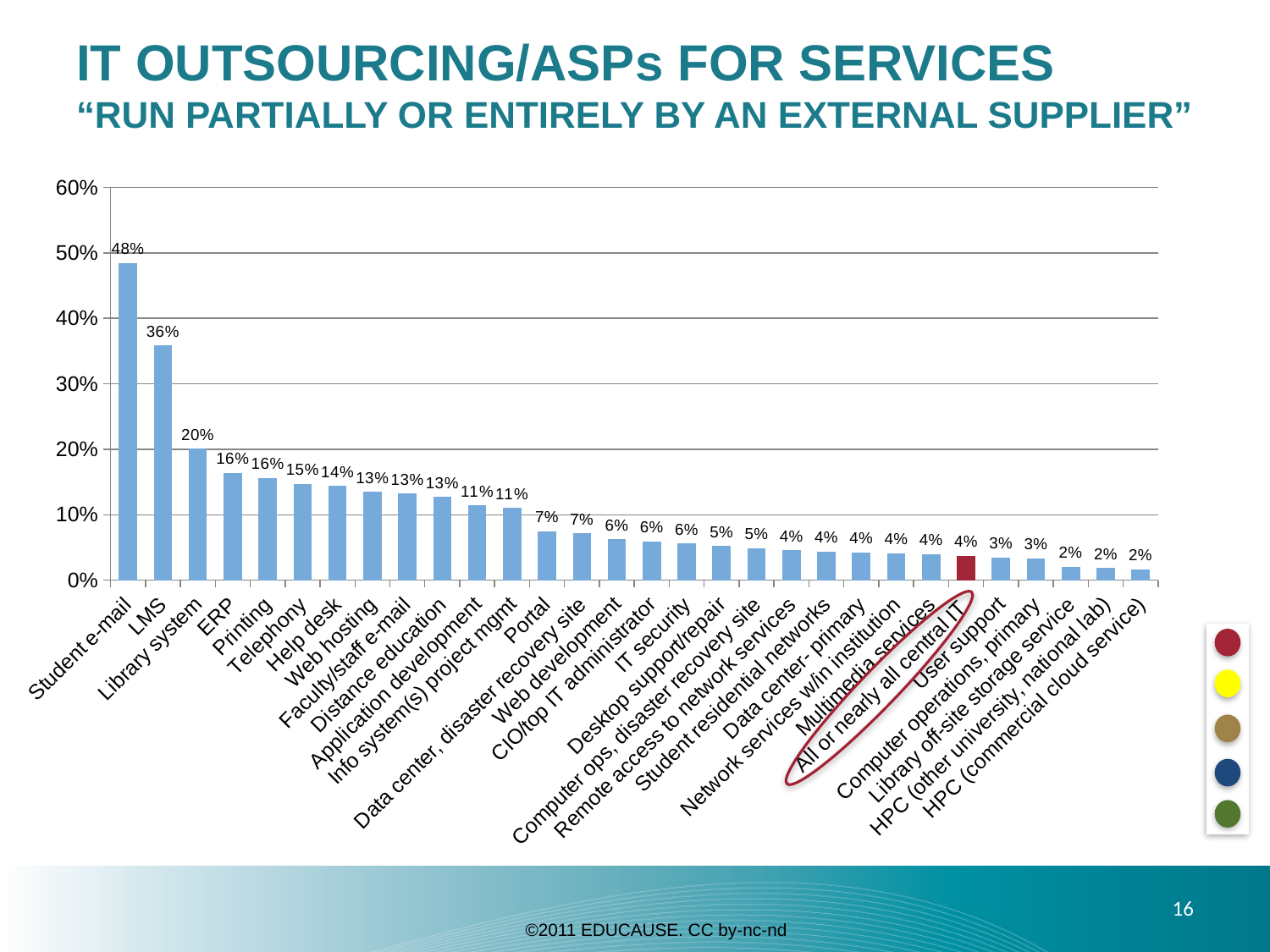
Is the value for Library system greater or less than 10%? greater What percentage is shown for Student e-mail? 48% What is the difference between Student e-mail and LMS? 12% What is the difference between Library system and Help desk? 6% What is the value for LMS? 36% How many services are shown on the x axis? 30 Which service has the highest percentage? Student e-mail What is the value for the red bar, All or nearly all central IT? 4% Do the values rise or fall moving from left to right along the x axis? Fall Which is larger, the value for ERP or the value for Portal? ERP What percentage is shown for Telephony? 15% What kind of chart is shown on the slide? Bar chart